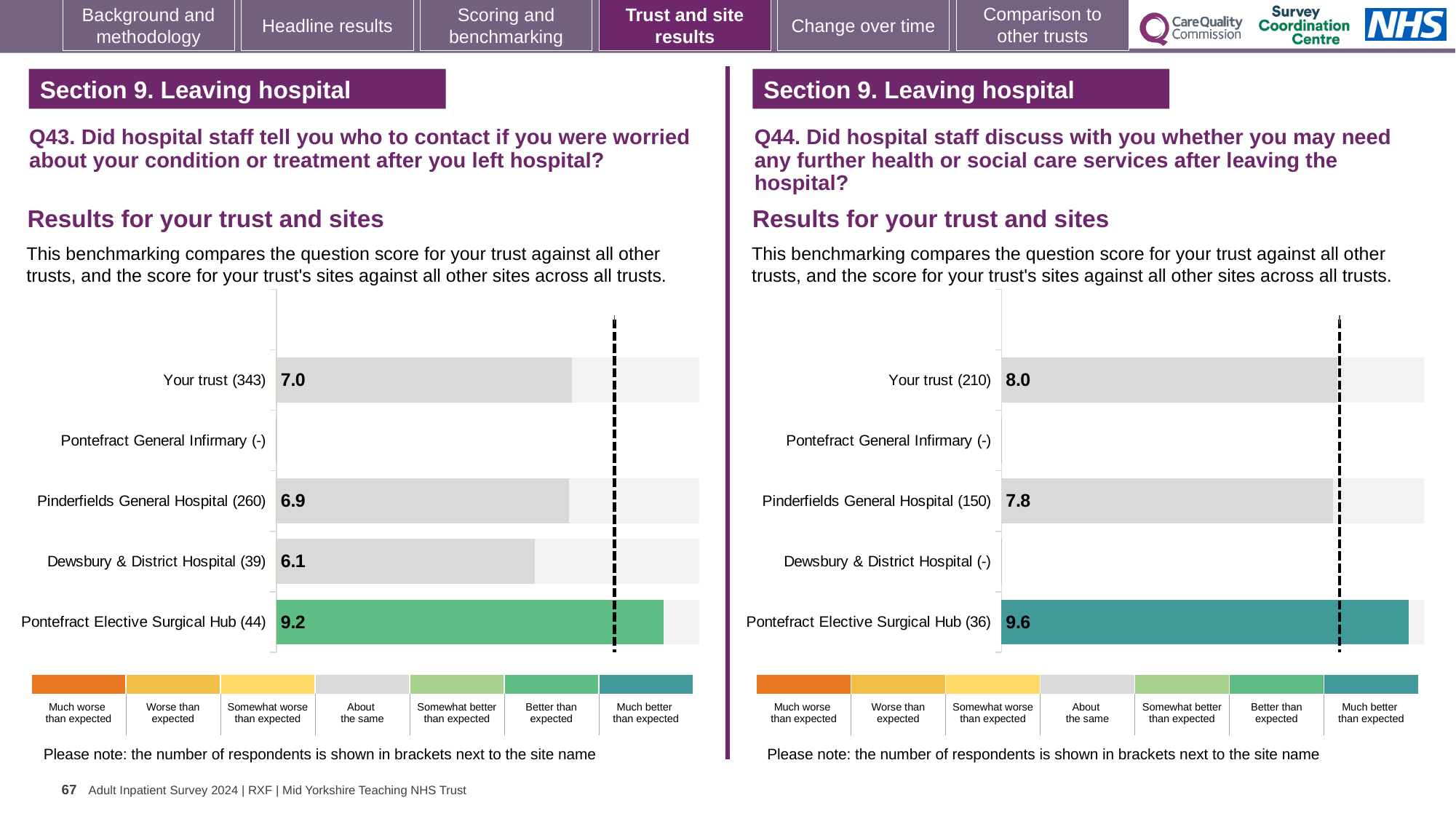
In the Q44 chart on the right, what is the score for Pinderfields General Hospital? 7.8 In the Q43 chart on the left, what is the difference between the scores for Pontefract Elective Surgical Hub and Your trust? 2.2 In the Q44 chart on the right, how many respondents are shown in brackets for Your trust? 210 In the Q43 chart on the left, what is the score for Your trust? 7.0 In the Q43 chart on the left, what is the score for Pontefract Elective Surgical Hub? 9.2 In the Q43 chart on the left, what is the score for Dewsbury & District Hospital? 6.1 In the Q44 chart on the right, what is the difference between the scores for Your trust and Pinderfields General Hospital? 0.2 In the Q44 chart on the right, which site has the highest score? Pontefract Elective Surgical Hub In the Q44 chart on the right, which is larger: the score for Your trust or the score for Pontefract Elective Surgical Hub? Pontefract Elective Surgical Hub What kind of chart is used in the Q43 chart on the left? Bar chart In the Q43 chart on the left, which site has the lowest score? Dewsbury & District Hospital In the Q44 chart on the right, what is the score for Pontefract Elective Surgical Hub? 9.6